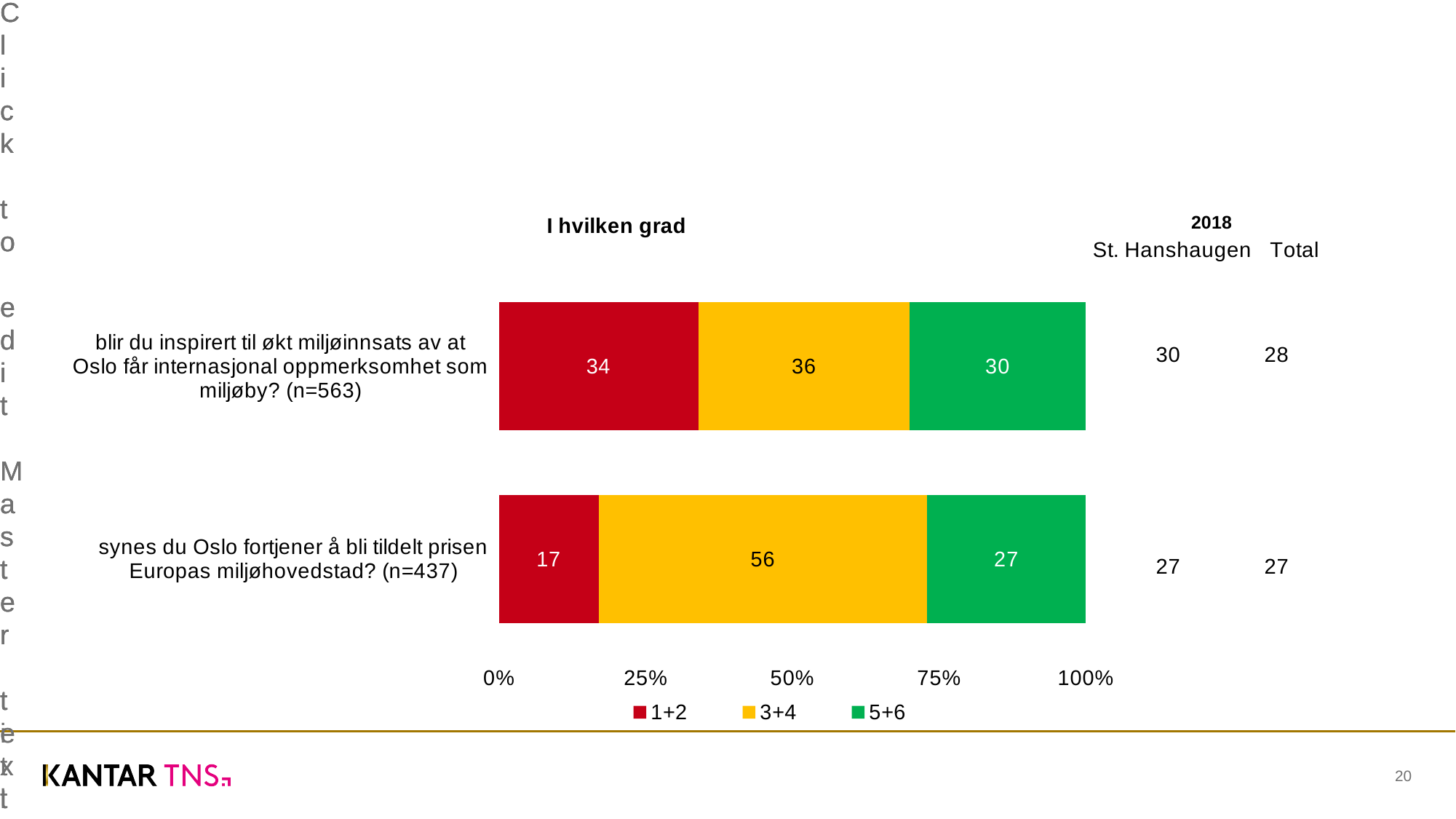
What is the difference between the 1+2 values of the two bars (34 and 17)? 17 What is the value of the 5+6 segment for 'synes du Oslo fortjener å bli tildelt prisen Europas miljøhovedstad?'? 27 What is the value of the 3+4 segment for 'synes du Oslo fortjener å bli tildelt prisen Europas miljøhovedstad?'? 56 Which segment is the smallest in the bar for 'synes du Oslo fortjener å bli tildelt prisen Europas miljøhovedstad?'? 1+2 How many series does the legend list? 3 What kind of chart is shown on the slide? Stacked bar chart What is the value of the 1+2 segment for 'blir du inspirert til økt miljøinnsats av at Oslo får internasjonal oppmerksomhet som miljøby?'? 34 What is the total of the stacked bar for 'blir du inspirert til økt miljøinnsats av at Oslo får internasjonal oppmerksomhet som miljøby?'? 100 Which bar has the larger 3+4 value: 'blir du inspirert til økt miljøinnsats...' or 'synes du Oslo fortjener å bli tildelt prisen...'? synes du Oslo fortjener å bli tildelt prisen Europas miljøhovedstad? What colour represents the 5+6 series in the legend? Green Which segment is the largest in the bar for 'synes du Oslo fortjener å bli tildelt prisen Europas miljøhovedstad?'? 3+4 How many categories (questions) are plotted in the chart? 2